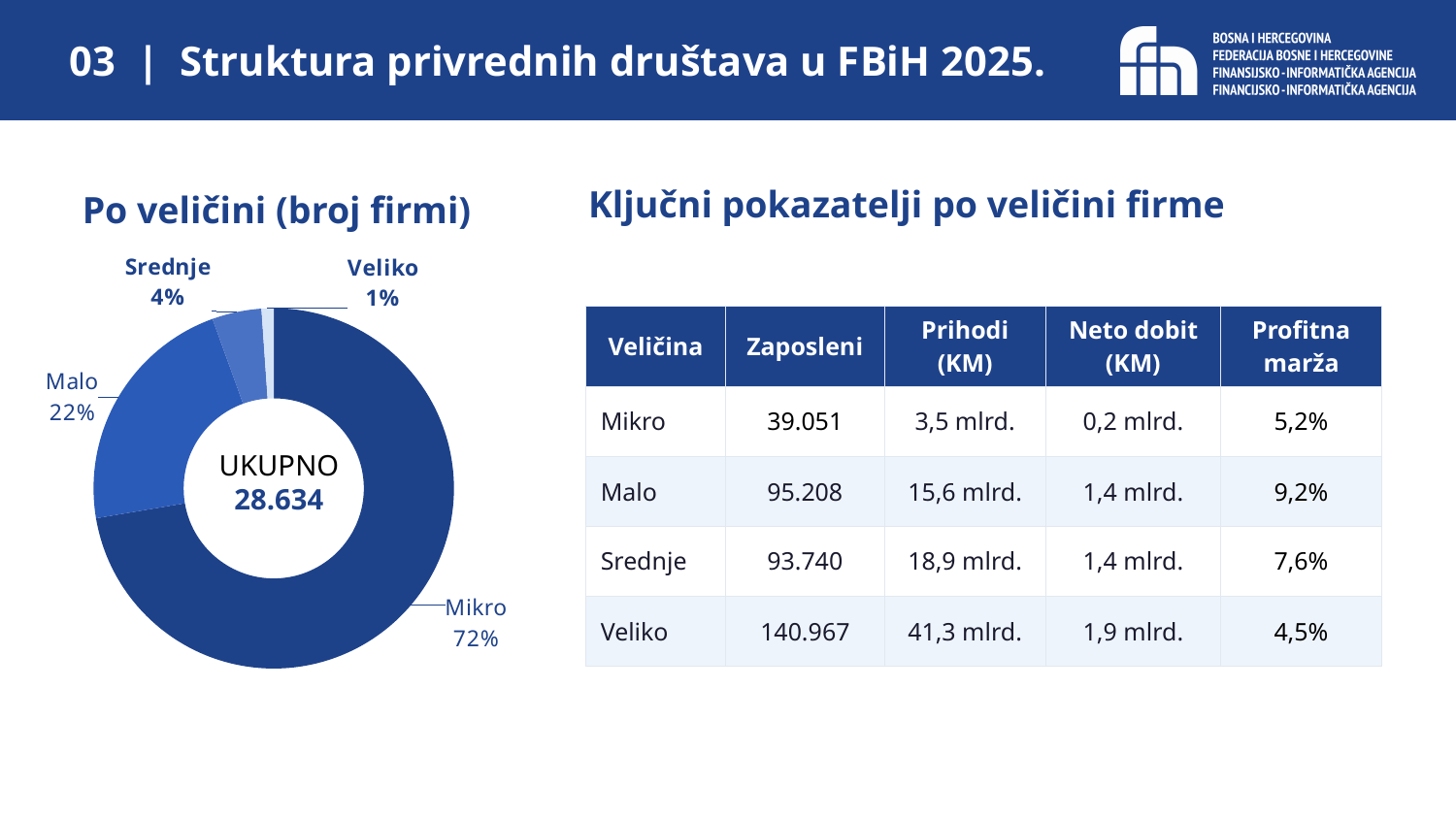
What is the difference in percentage points between the Mikro and Malo shares in the donut chart? 50 What is the title of the donut chart? Po veličini (broj firmi) What percentage is shown for Malo in the donut chart? 22% What percentage is shown for Srednje in the donut chart? 4% How many categories are shown in the donut chart? 4 What total (UKUPNO) is shown in the centre of the donut chart? 28.634 Which category has the largest share in the donut chart? Mikro What type of chart is used to show the structure by size (number of firms)? Donut (pie) chart What percentage is shown for Veliko in the donut chart? 1% Which category has the smallest share in the donut chart? Veliko What share of the donut chart does Mikro represent? 72% Which has a larger share in the donut chart, Malo or Srednje? Malo